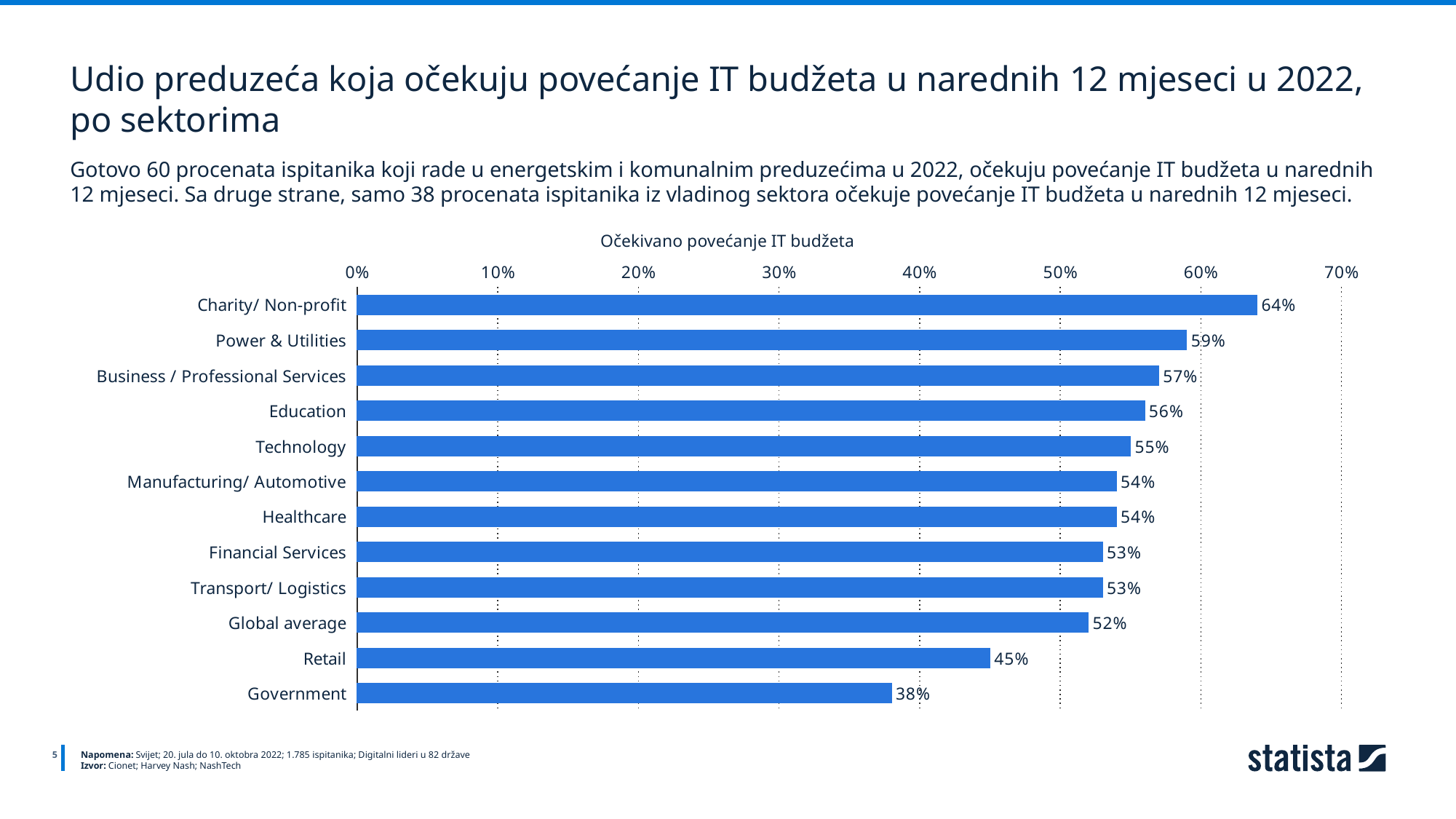
Which category has the lowest value? Government What is the value for Charity/ Non-profit? 64% What is the value for Education? 56% How many categories are shown in the chart? 12 What is the value for Global average? 52% What is the difference between the values for Power & Utilities and Retail? 14% What is the title of the chart? Očekivano povećanje IT budžeta Which category has the highest value? Charity/ Non-profit Which is larger, the value for Technology or the value for Retail? Technology What kind of chart is shown on the slide? Bar chart What is the difference between the values for Charity/ Non-profit and Government? 26% What is the value for Government? 38%